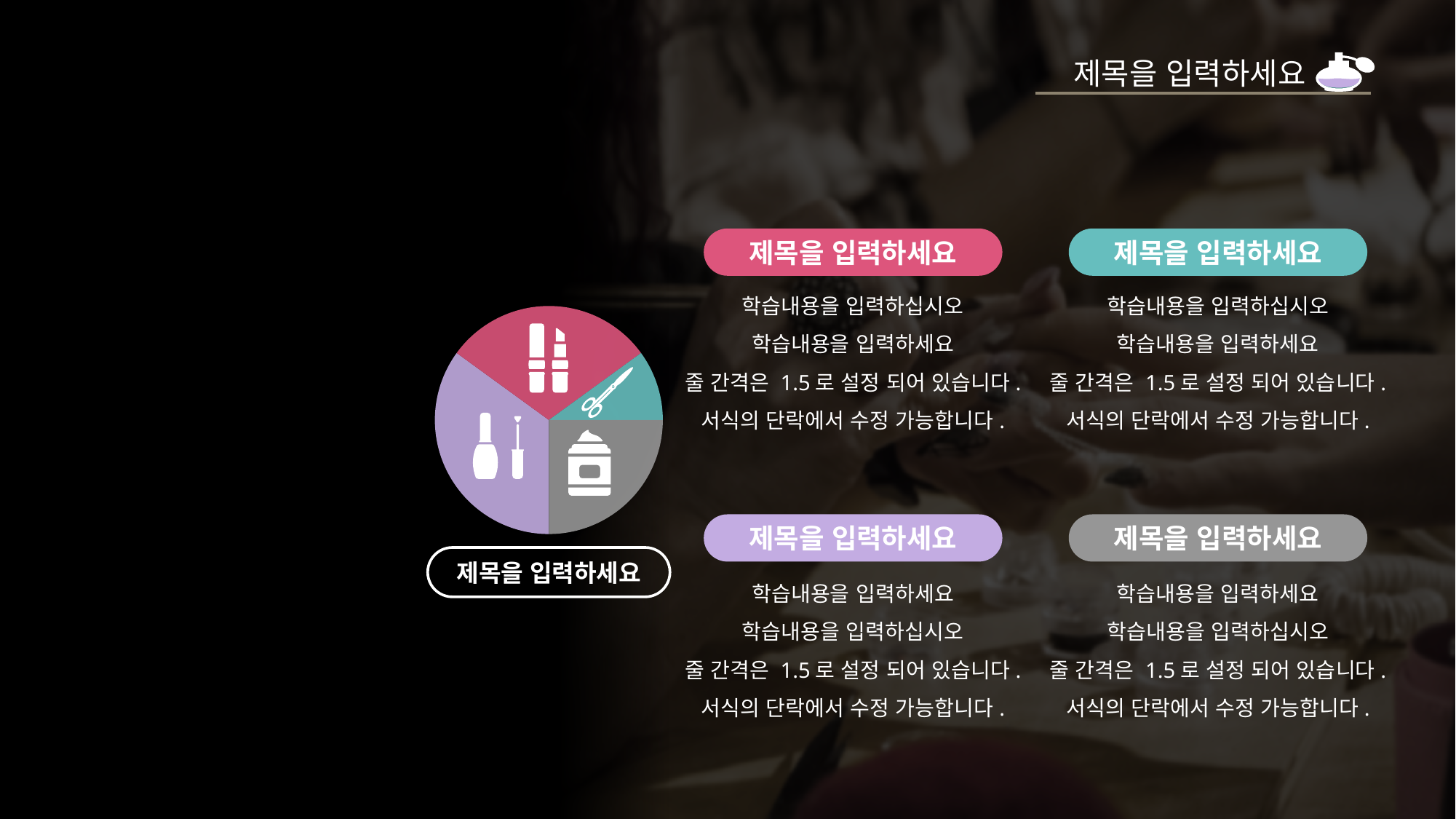
In the pie chart, is the pink slice or the teal slice larger? pink How many slices does the pie chart on the left of the slide have? 4 What icon is shown in the teal slice of the pie chart? scissors What is the text in the rounded label box below the pie chart? 제목을 입력하세요 In the pie chart, is the purple slice or the teal slice larger? purple Which colour slice of the pie chart is the smallest? teal What kind of chart is shown on the left of the slide? pie chart